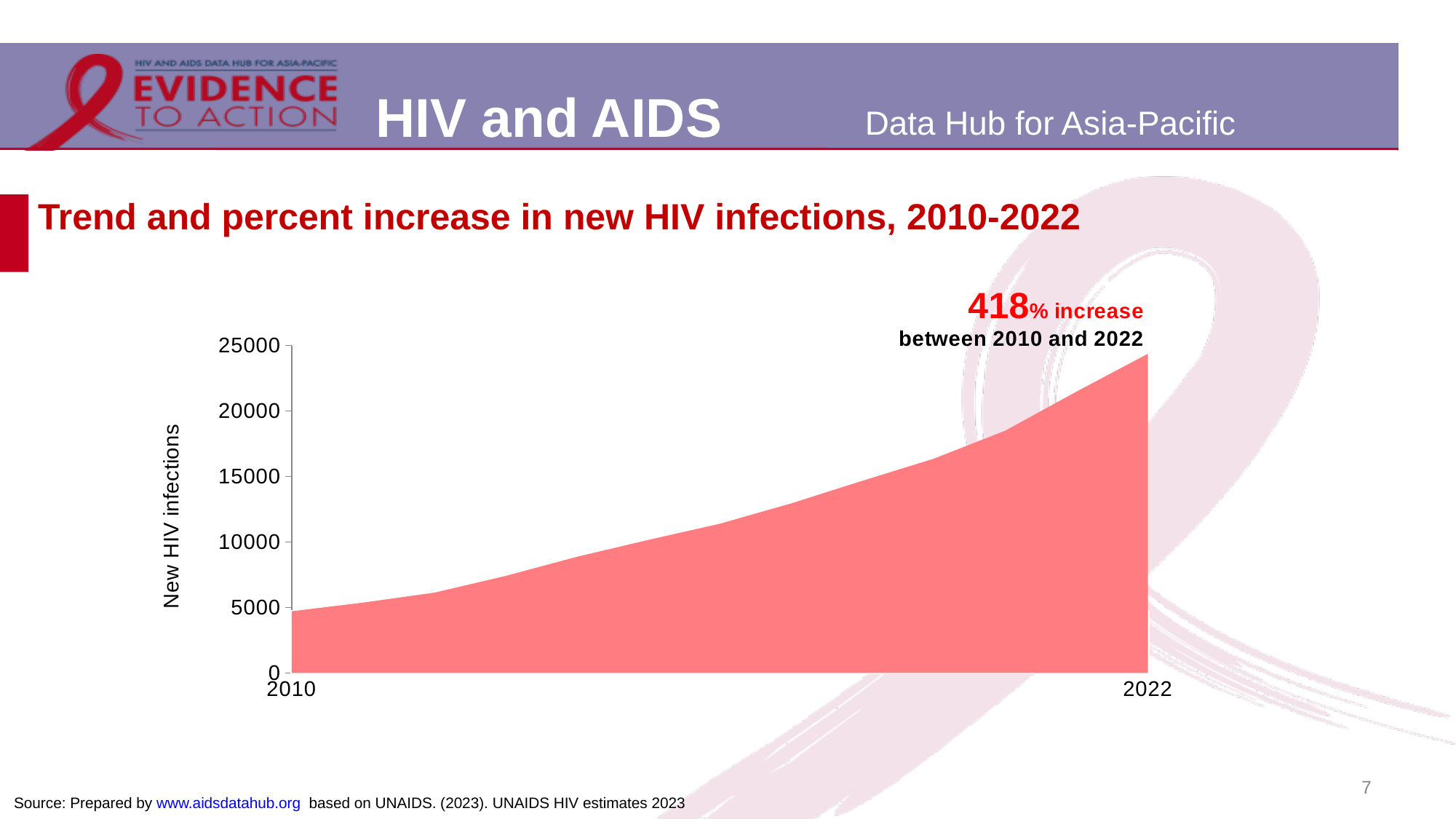
Which year has more new HIV infections, 2010 or 2022? 2022 What percent increase in new HIV infections between 2010 and 2022 is stated on the slide? 418% Is the value for new HIV infections in 2010 greater or less than 10000? less What is the highest value shown on the y axis? 25000 Which year shown on the x axis has the highest number of new HIV infections? 2022 Is the value for new HIV infections in 2022 greater or less than 25000? less What is the title of the chart? Trend and percent increase in new HIV infections, 2010-2022 Which year shown on the x axis has the lowest number of new HIV infections? 2010 Do new HIV infections rise or fall from 2010 to 2022? Rise What is the label on the y axis of the chart? New HIV infections Is the value for new HIV infections in 2022 greater or less than 20000? greater What kind of chart is shown on the slide? Area chart